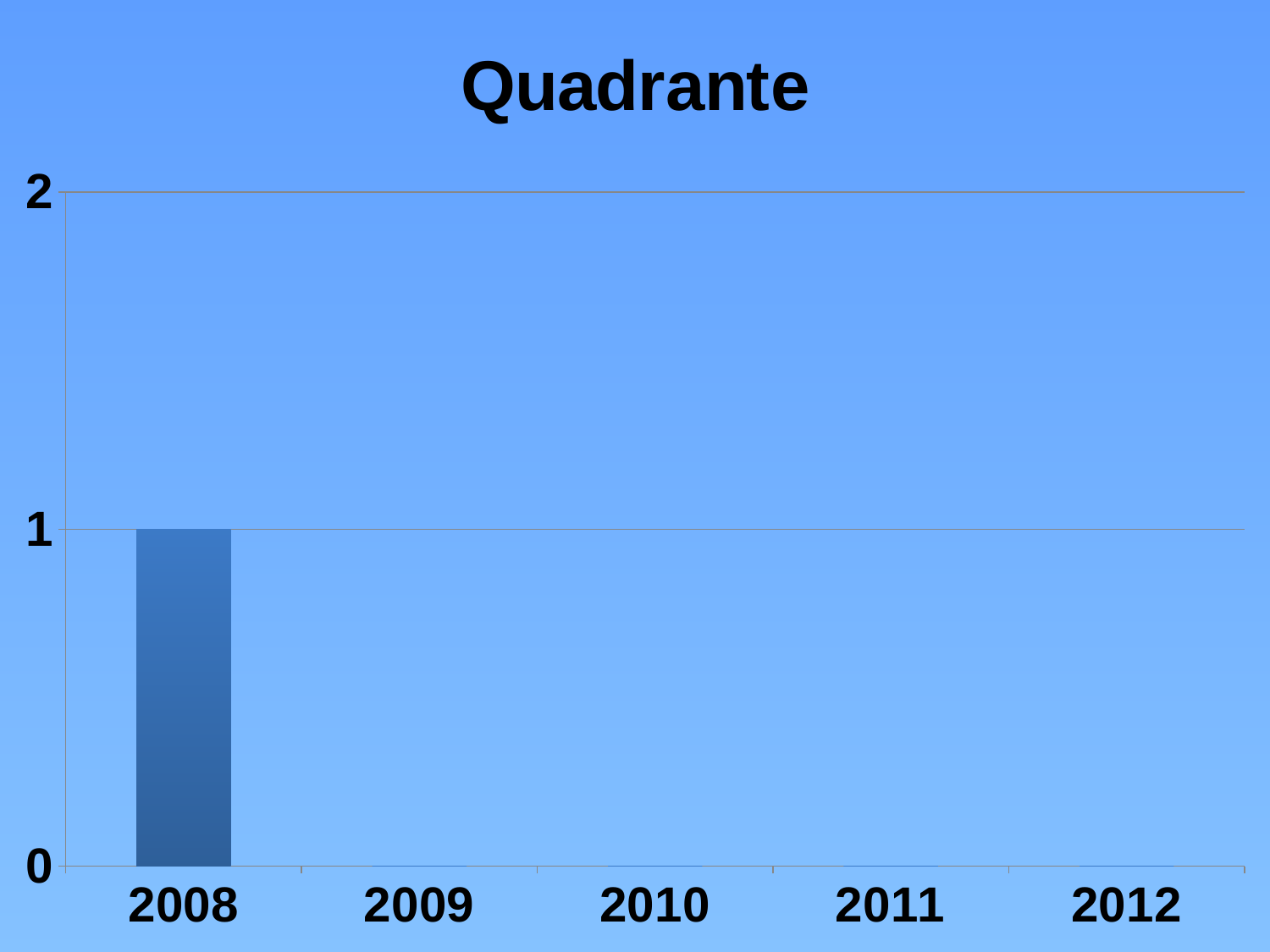
Is the value for 2008 larger than the value for 2010? Yes What is the first year shown on the x axis? 2008 What is the highest value shown on the y axis? 2 What is the value for 2008? 1 Which year has the highest value? 2008 How many years are shown on the x axis? 5 Which is the only year with a visible bar? 2008 Is the value for 2008 greater or less than 2? less What is the last year shown on the x axis? 2012 What kind of chart is shown on the slide? bar chart What is the title of the chart? Quadrante